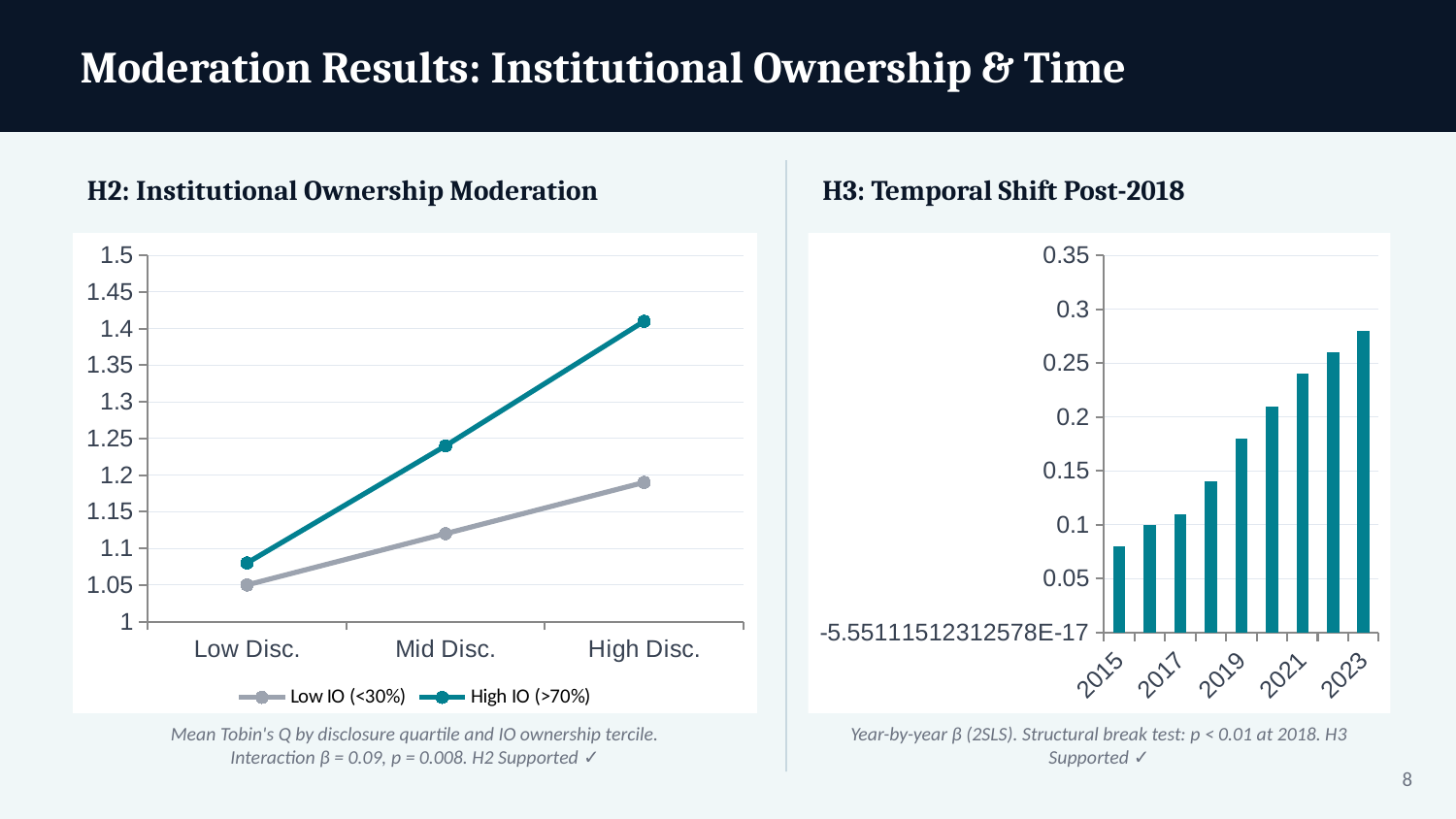
In the H2: Institutional Ownership Moderation chart, what are the two legend entries? Low IO (<30%) and High IO (>70%) In the H3: Temporal Shift Post-2018 chart, how many bars are plotted? 9 What kind of chart is the H2: Institutional Ownership Moderation chart on the left? Line chart In the H3: Temporal Shift Post-2018 chart, which year has the lowest bar? 2015 In the H2: Institutional Ownership Moderation chart, how many series does the legend list? 2 In the H3: Temporal Shift Post-2018 chart, do the values rise or fall from 2015 to 2023? Rise In the H3: Temporal Shift Post-2018 chart, is the value for 2023 greater or less than 0.25? greater In the H2: Institutional Ownership Moderation chart, at High Disc., which series has the larger value, Low IO (<30%) or High IO (>70%)? High IO (>70%) What kind of chart is the H3: Temporal Shift Post-2018 chart on the right? Bar chart In the H2: Institutional Ownership Moderation chart, is the High IO (>70%) value at High Disc. greater or less than 1.3? greater In the H2: Institutional Ownership Moderation chart, how many categories are shown on the x axis? 3 In the H3: Temporal Shift Post-2018 chart, which year has the highest bar? 2023